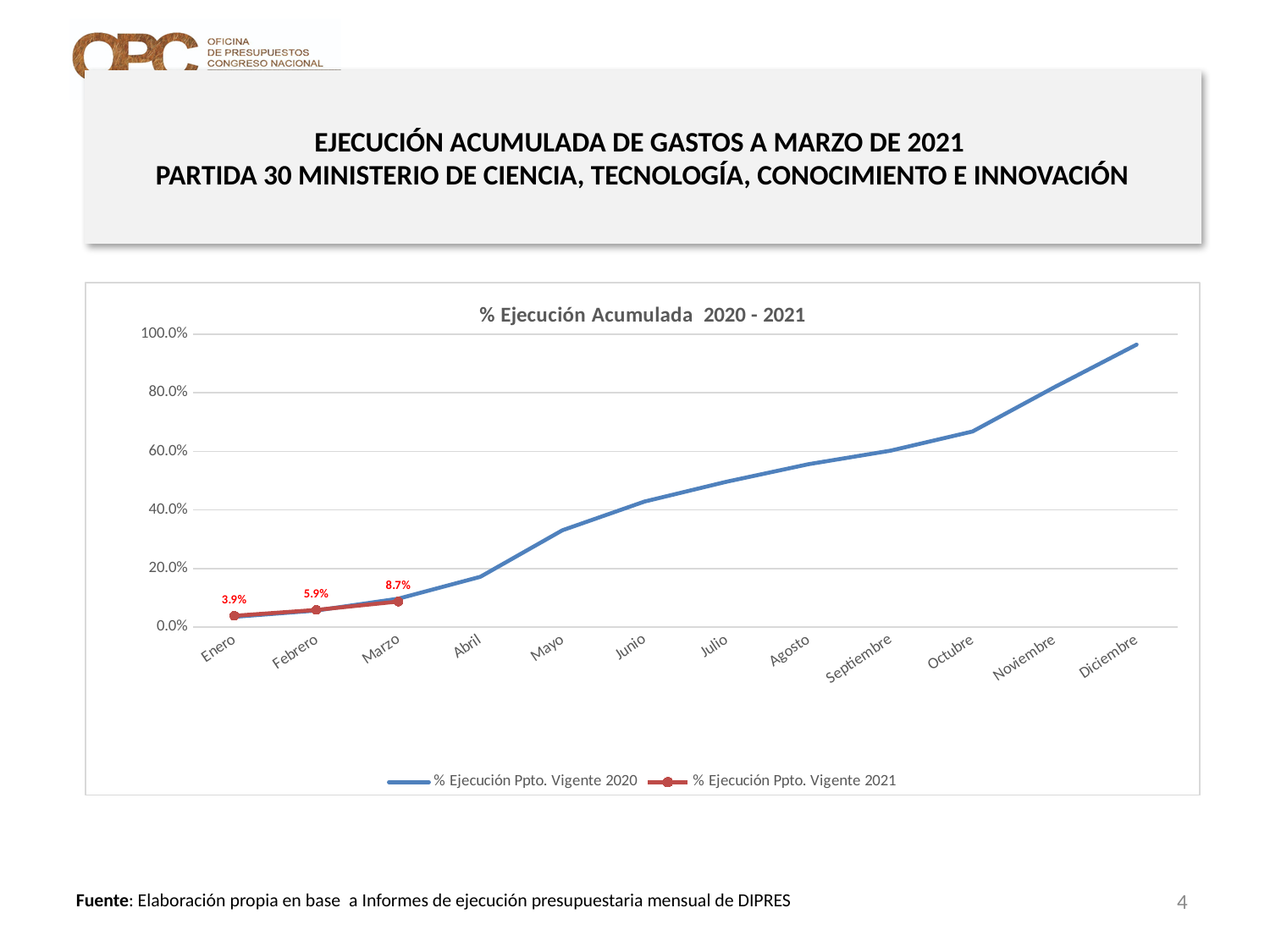
How many series does the legend list? 2 Is the value for % Ejecución Ppto. Vigente 2020 in Diciembre greater or less than 80.0%? greater By how many percentage points does the 2021 series increase from Enero to Marzo? 4.8 What is the value of % Ejecución Ppto. Vigente 2021 for Febrero? 5.9% What is the value of % Ejecución Ppto. Vigente 2021 for Enero? 3.9% What kind of chart is shown on the slide? Line chart Which month has the highest value for the % Ejecución Ppto. Vigente 2021 series? Marzo What is the title of the chart? % Ejecución Acumulada 2020 - 2021 What is the value of % Ejecución Ppto. Vigente 2021 for Marzo? 8.7% Is the value for % Ejecución Ppto. Vigente 2020 in Agosto greater or less than 60.0%? less Does the % Ejecución Ppto. Vigente 2020 series rise or fall from Enero to Diciembre? Rise How many months are shown on the x axis? 12